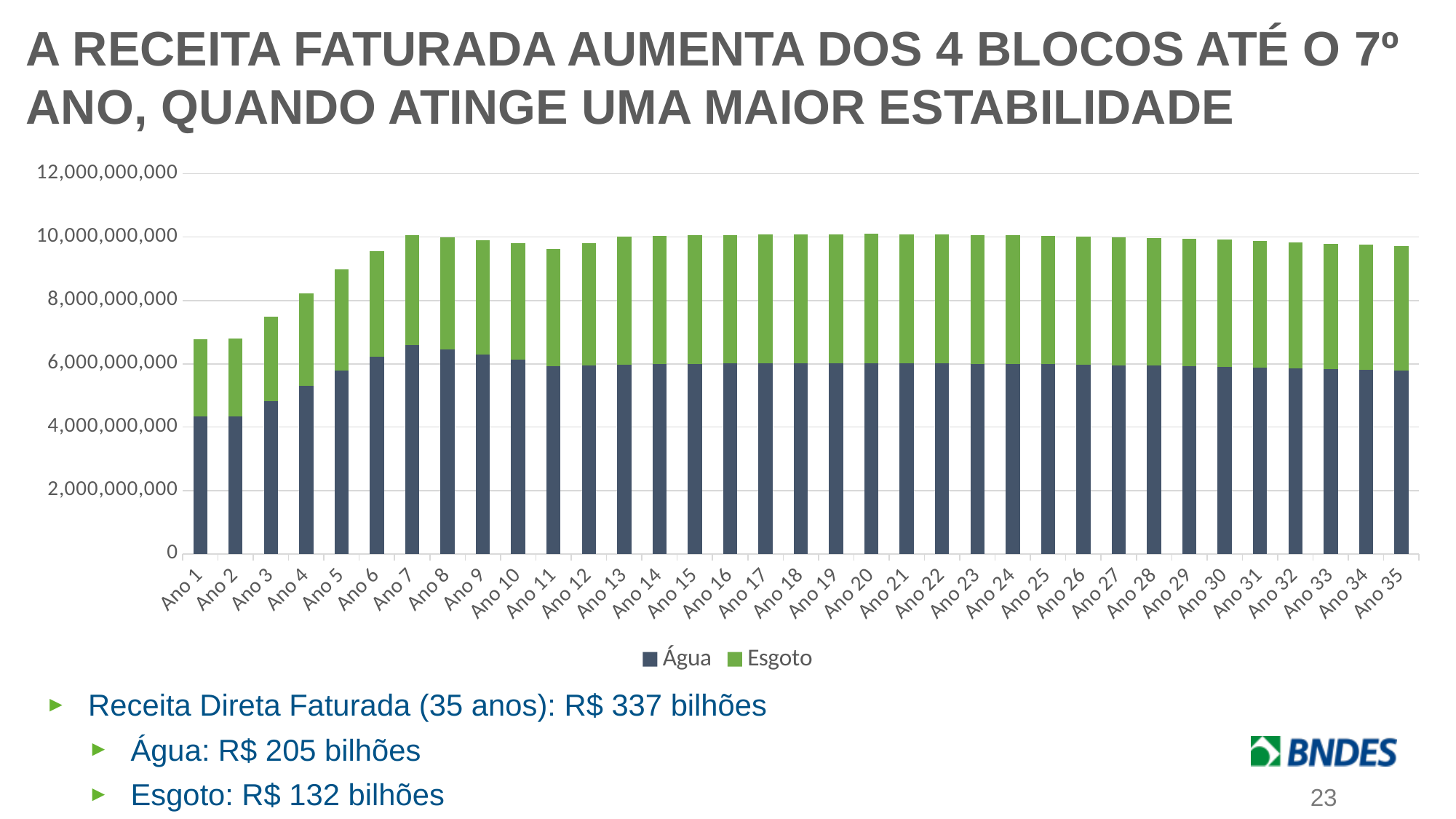
Which has the larger Água value, Ano 1 or Ano 7? Ano 7 Which colour represents the Esgoto series in the chart? Green What kind of chart is shown on the slide? Stacked bar chart Is the total stacked value for Ano 3 greater or less than 8,000,000,000? less Is the total stacked value for Ano 5 greater or less than 8,000,000,000? greater Is the Água value for Ano 1 greater or less than 4,000,000,000? greater How many series does the chart's legend list? 2 Do the total stacked values rise or fall from Ano 1 to Ano 7? Rise What are the two series named in the chart's legend? Água and Esgoto How many years (categories) are plotted along the x axis of the chart? 35 Which has the larger total stacked value, Ano 1 or Ano 10? Ano 10